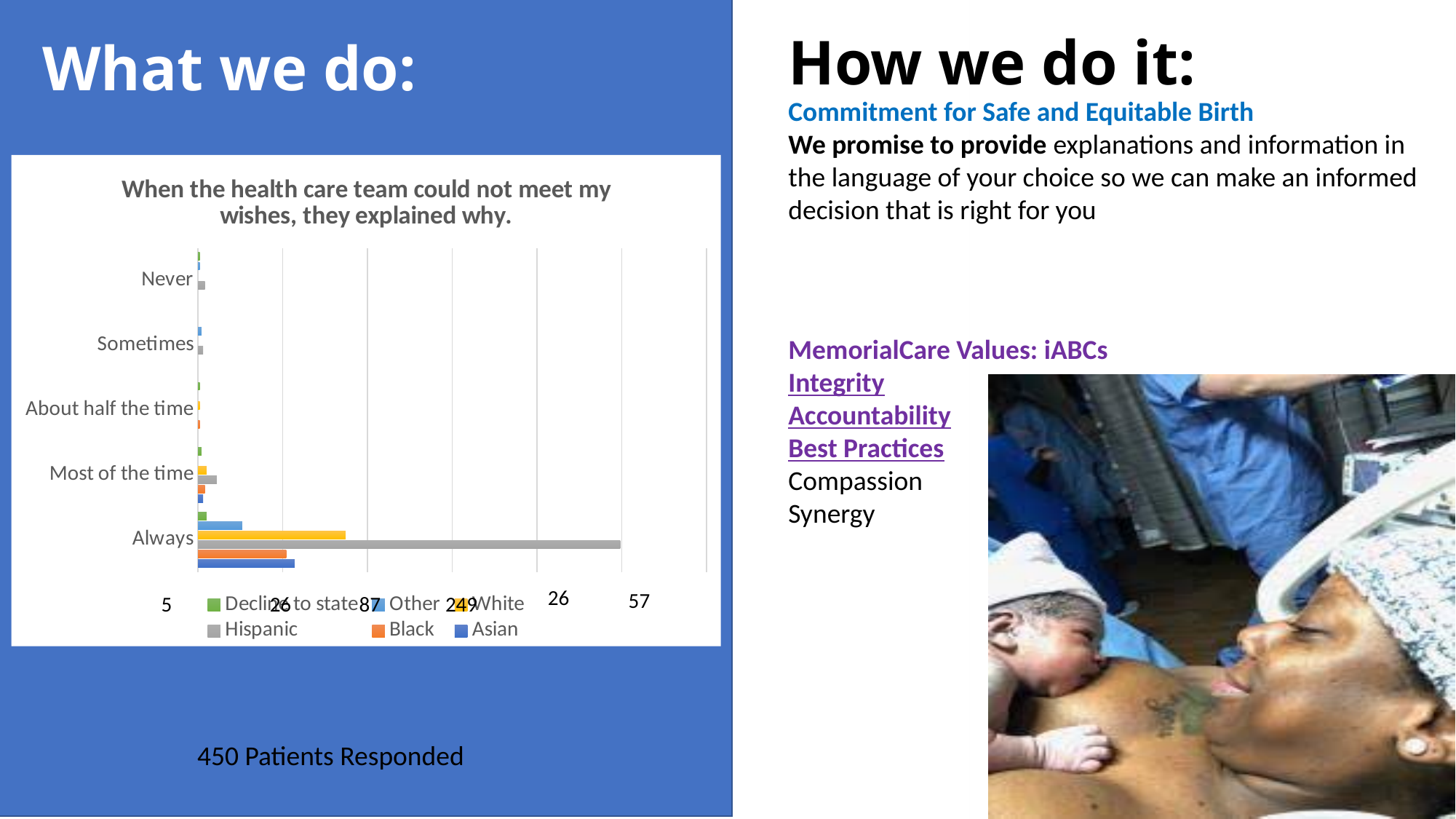
Within the 'Always' category, is the Asian bar longer or shorter than the Hispanic bar? shorter What is the title of the chart? When the health care team could not meet my wishes, they explained why. Which response category has the longest bars overall in the chart? Always Is the Hispanic bar for 'Always' longer or shorter than the Hispanic bar for 'Never'? longer Which colour represents the Hispanic series in the chart's legend? gray Within the 'Always' category, which series has the longest bar? Hispanic How many response categories are shown on the y axis of the chart? 5 What kind of chart is shown on the slide? bar chart Within the 'Always' category, which series has the second-longest bar? White Within the 'Always' category, is the Hispanic bar longer or shorter than the White bar? longer How many series does the chart's legend list? 6